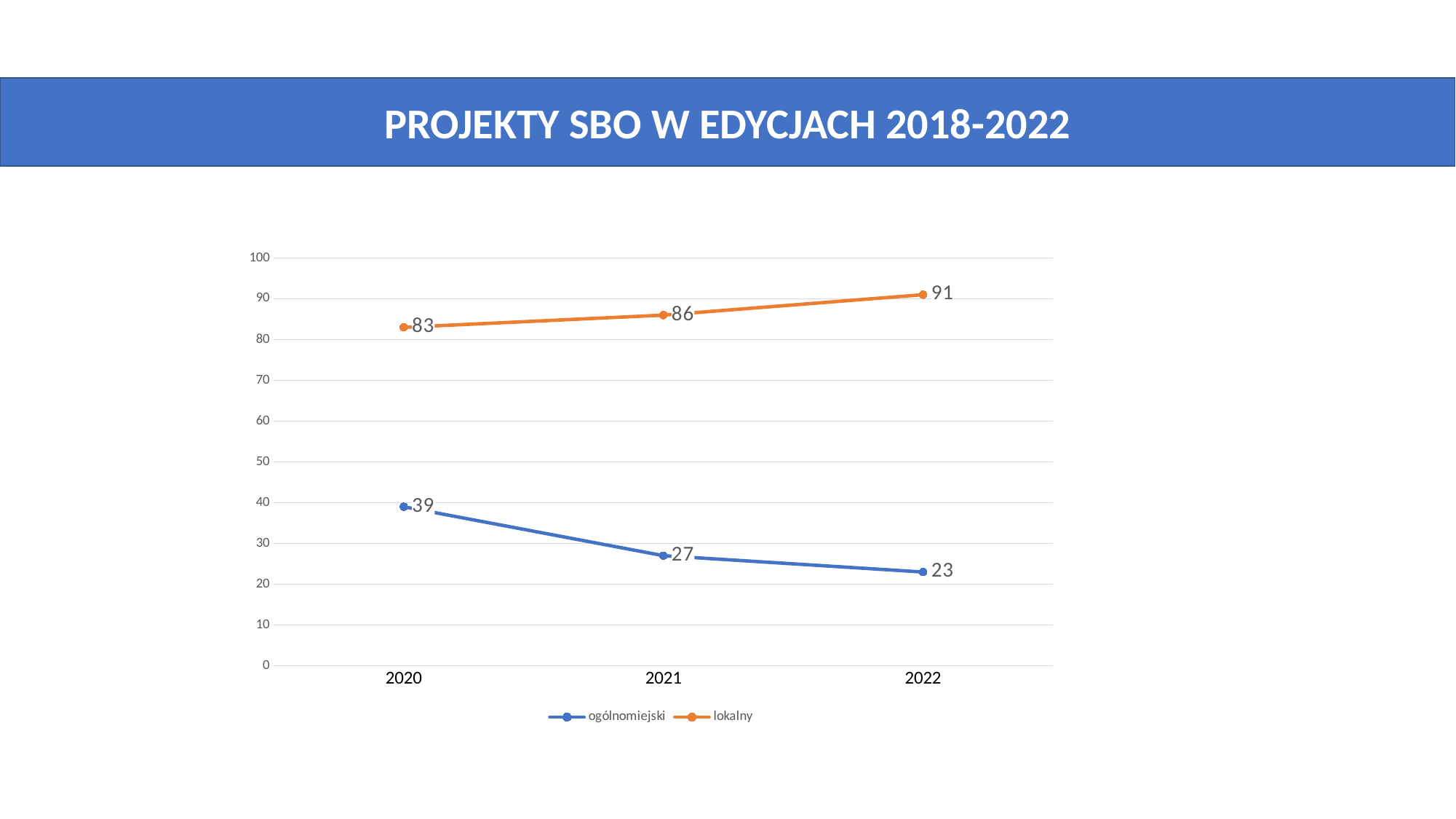
In which year is the ogólnomiejski series lowest? 2022 How many series does the legend list? 2 Which series has the larger value in 2022, ogólnomiejski or lokalny? lokalny How many years are shown on the x axis? 3 What is the value for ogólnomiejski in 2022? 23 Does the ogólnomiejski series rise or fall from 2020 to 2022? fall What is the value for lokalny in 2021? 86 By how much did the ogólnomiejski value change from 2020 to 2021? 12 What kind of chart is shown on the slide? line chart In which year is the lokalny series highest? 2022 What is the difference between lokalny and ogólnomiejski in 2020? 44 What is the value for ogólnomiejski in 2020? 39